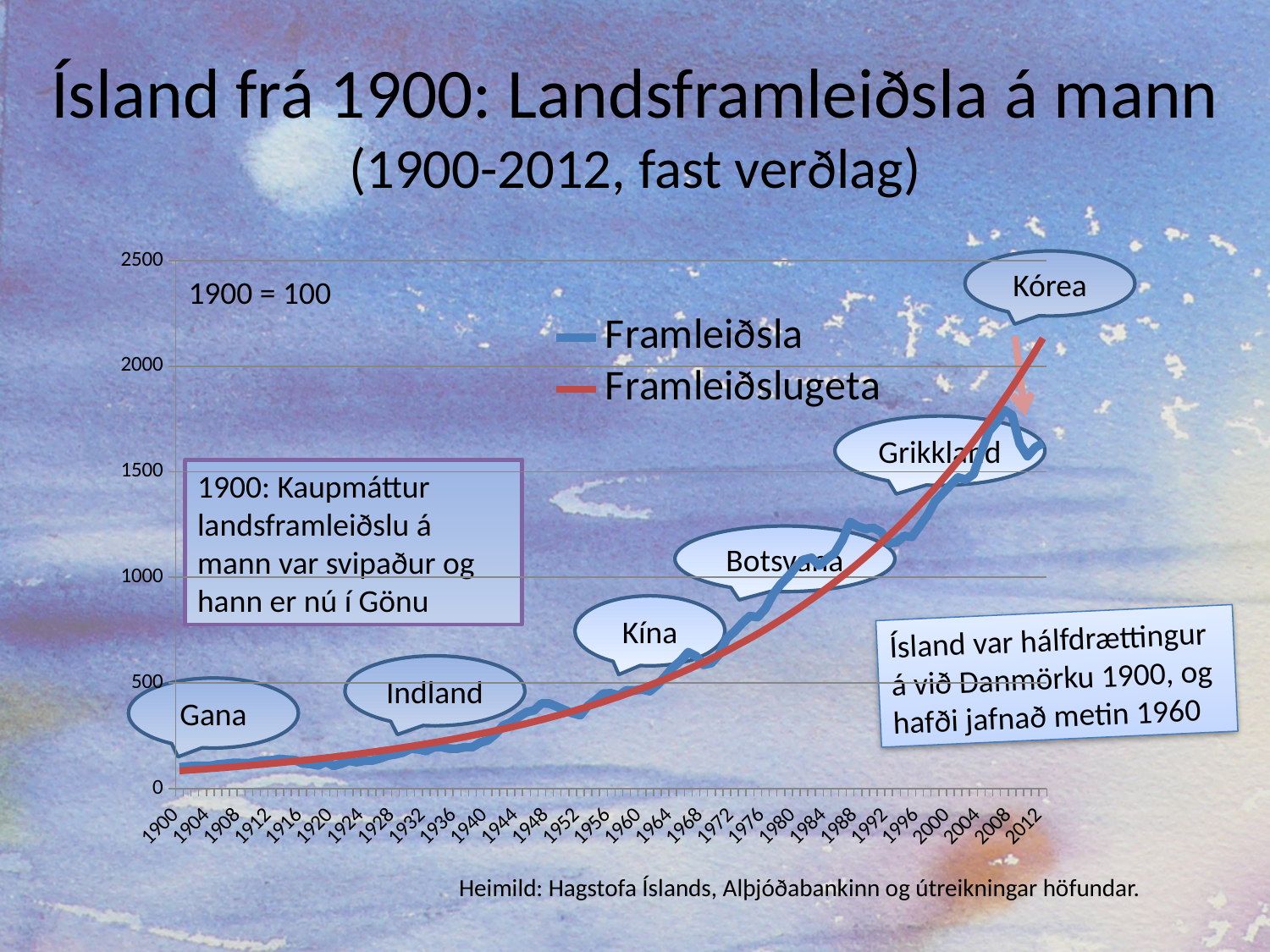
How many series does the chart's legend list? 2 Is the value of Framleiðsla in 2012 greater or less than 1000? greater In 2012, which series has the larger value, Framleiðsla or Framleiðslugeta? Framleiðslugeta What is the last year labelled on the chart's horizontal axis? 2012 Which colour is used for the Framleiðslugeta series? red What kind of chart is shown on the slide? line chart Is the value of Framleiðsla in 1900 greater or less than 500? less What is the highest value shown on the chart's vertical axis? 2500 Is the value of Framleiðslugeta in 2012 greater or less than 2000? greater Does the Framleiðsla series generally rise or fall from 1900 to 2012? rise What are the two series named in the chart's legend? Framleiðsla and Framleiðslugeta